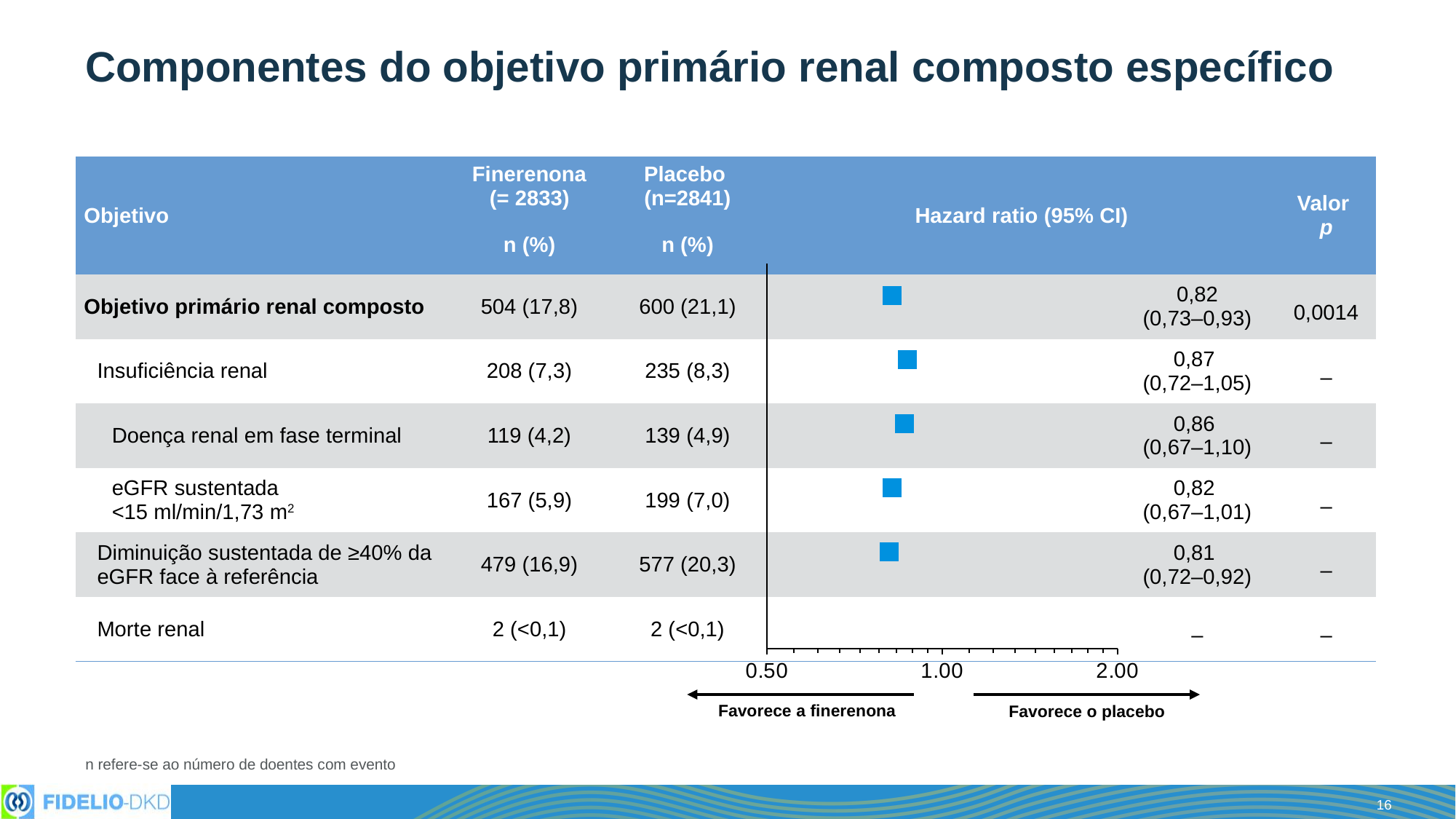
What is the hazard ratio for Diminuição sustentada de ≥40% da eGFR face à referência? 0,81 Is the hazard ratio for Doença renal em fase terminal greater or less than 1.00? less How many outcomes have a hazard ratio point plotted on the chart? 5 What is the hazard ratio for Objetivo primário renal composto? 0,82 What is the 95% CI for the hazard ratio of Insuficiência renal? 0,72–1,05 What does the left side of the hazard ratio axis favour, according to the label below the chart? Favorece a finerenona What is the difference between the hazard ratios for Insuficiência renal and Diminuição sustentada de ≥40% da eGFR face à referência? 0,06 Which has the larger hazard ratio, Insuficiência renal or Diminuição sustentada de ≥40% da eGFR face à referência? Insuficiência renal Which outcome has the lowest hazard ratio plotted? Diminuição sustentada de ≥40% da eGFR face à referência What kind of chart is used to display the hazard ratios? Forest plot What is the p value shown for Objetivo primário renal composto? 0,0014 Which outcome has the highest hazard ratio plotted? Insuficiência renal